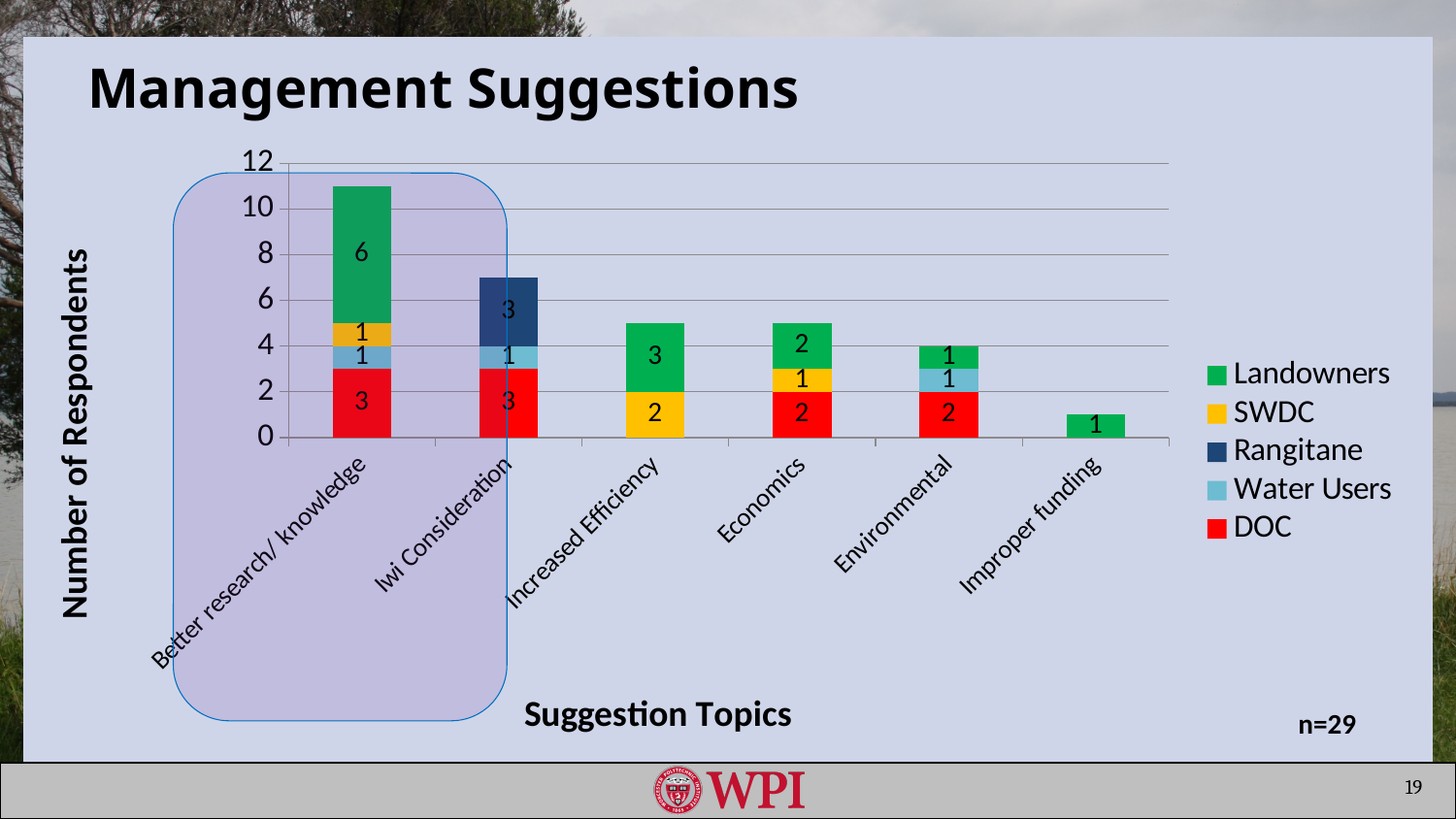
What type of chart is shown on the slide? stacked bar chart What is the total number of respondents for the Iwi Consideration bar? 7 What is the total number of respondents for the Better research/ knowledge bar? 11 Which is larger: the Landowners value for Increased Efficiency or the Landowners value for Environmental? Increased Efficiency How many Rangitane respondents suggested Iwi Consideration? 3 How many series does the legend list? 5 How many suggestion topics are shown on the x axis? 6 What is the difference between the DOC value for Better research/ knowledge and the DOC value for Economics? 1 How many Landowners respondents suggested Better research/ knowledge? 6 Which suggestion topic has the highest total number of respondents? Better research/ knowledge How many SWDC respondents suggested Increased Efficiency? 2 Which suggestion topic has the lowest total number of respondents? Improper funding